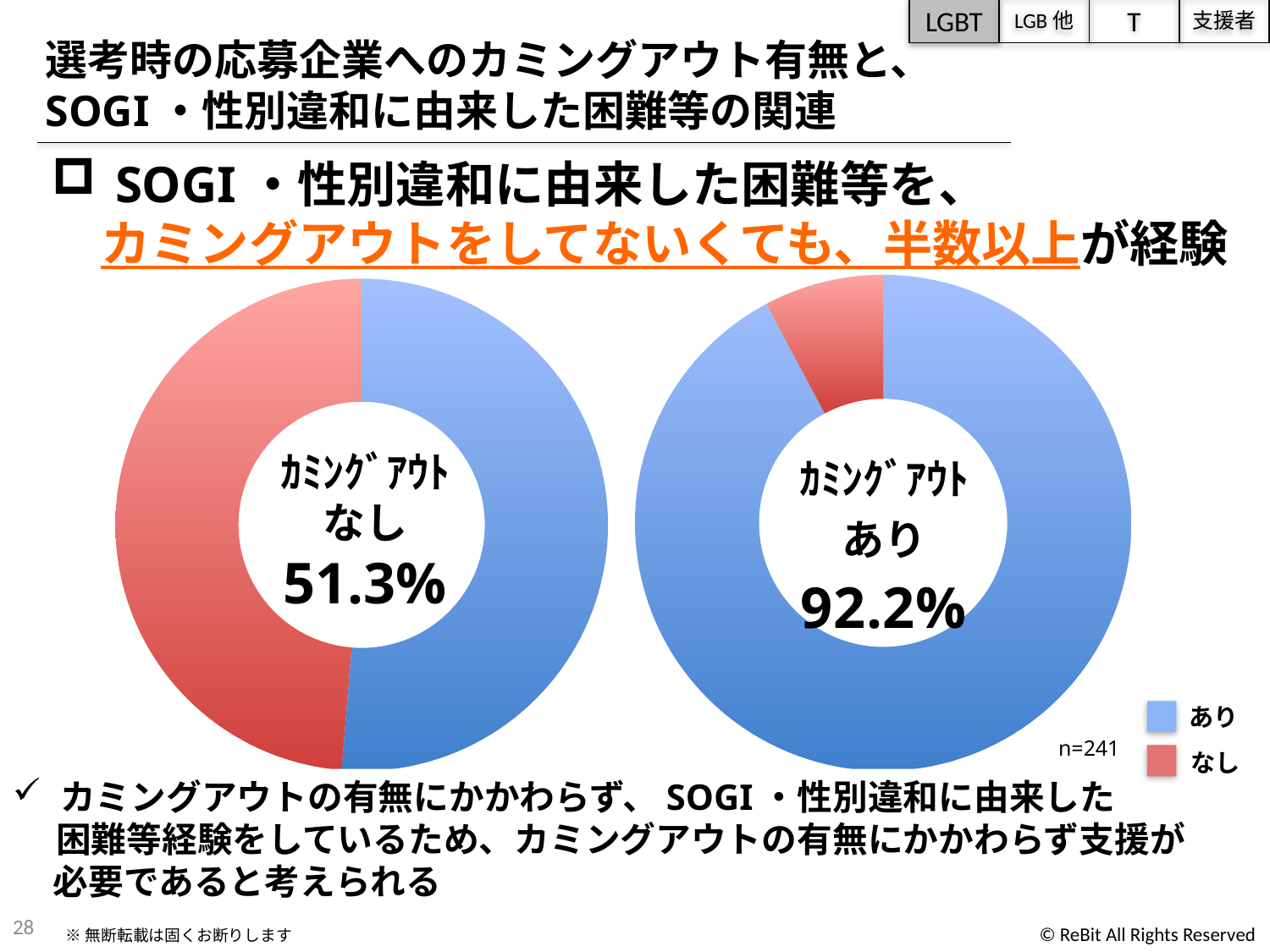
What is the difference between the percentage printed in the right chart (92.2%) and the percentage printed in the left chart (51.3%)? 40.9 percentage points How many entries does the legend list? 2 Which chart has the smaller red (なし) slice, the left one or the right one? The right one (カミングアウトあり) Which legend entry is shown in blue? あり In the left donut chart (カミングアウトなし), is the red (なし) slice greater or less than 50%? less What sample size (n) is printed next to the charts? n=241 In the right donut chart (カミングアウトあり), what percentage is printed in the centre? 92.2% In the right donut chart (カミングアウトあり), is the blue (あり) slice greater or less than 90%? greater What kind of charts are shown on the slide? Donut (pie) charts How many slices does each donut chart have? 2 In the left donut chart (カミングアウトなし), what percentage is printed in the centre? 51.3% Which chart shows the larger printed percentage, the left one (カミングアウトなし) or the right one (カミングアウトあり)? The right one (カミングアウトあり)